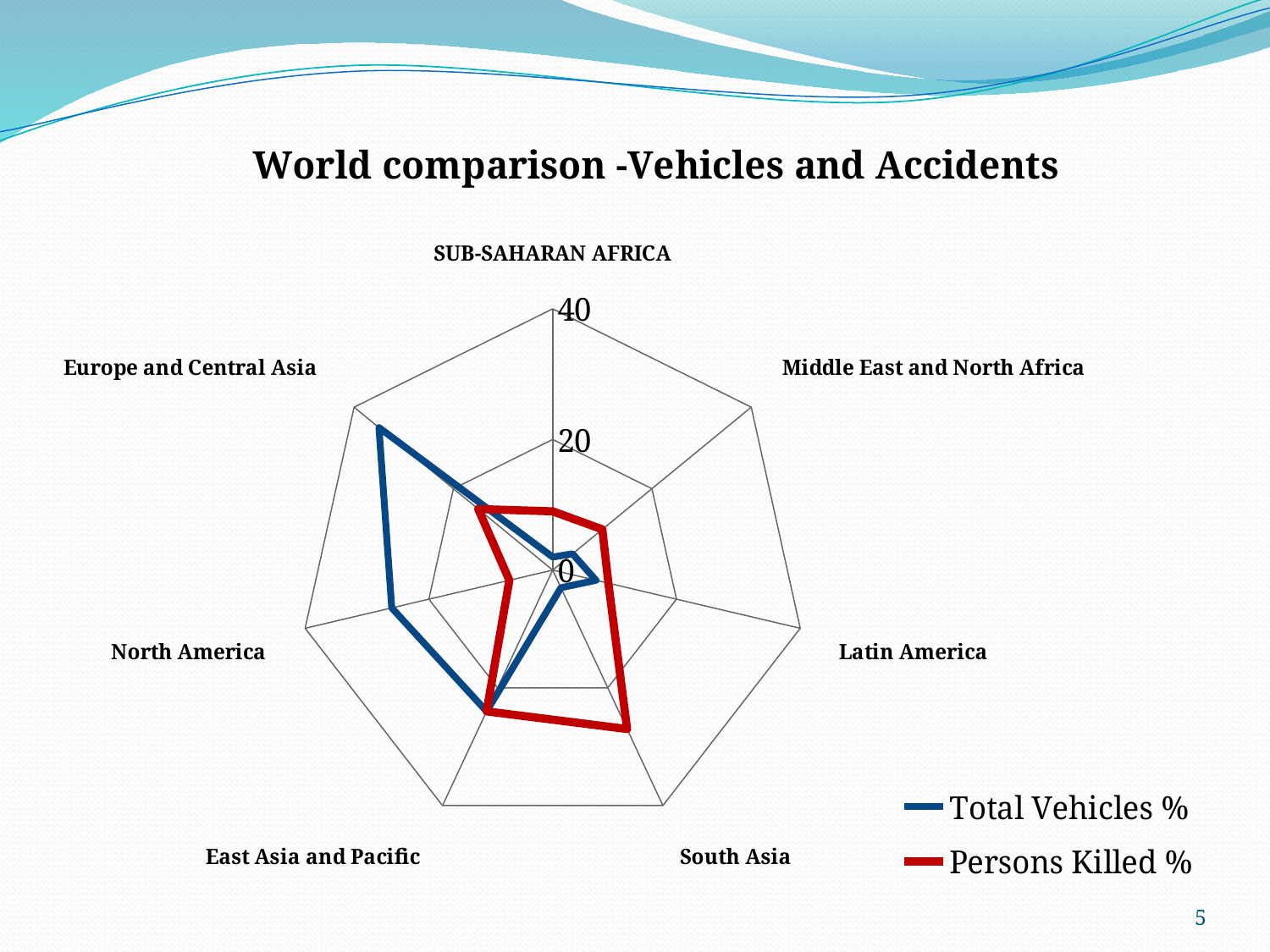
Is the Persons Killed % value for South Asia greater or less than 20? greater Is the Persons Killed % value for Middle East and North Africa greater or less than 20? less What kind of chart is shown on the slide? Radar chart For Europe and Central Asia, which is larger: Total Vehicles % or Persons Killed %? Total Vehicles % Which region has the highest Total Vehicles % value? Europe and Central Asia How many regions (categories) are plotted on the radar chart? 7 Which series is drawn in red? Persons Killed % What is the title of the chart? World comparison -Vehicles and Accidents For South Asia, which is larger: Total Vehicles % or Persons Killed %? Persons Killed % Is the Total Vehicles % value for Sub-Saharan Africa greater or less than 20? less How many series does the legend list? 2